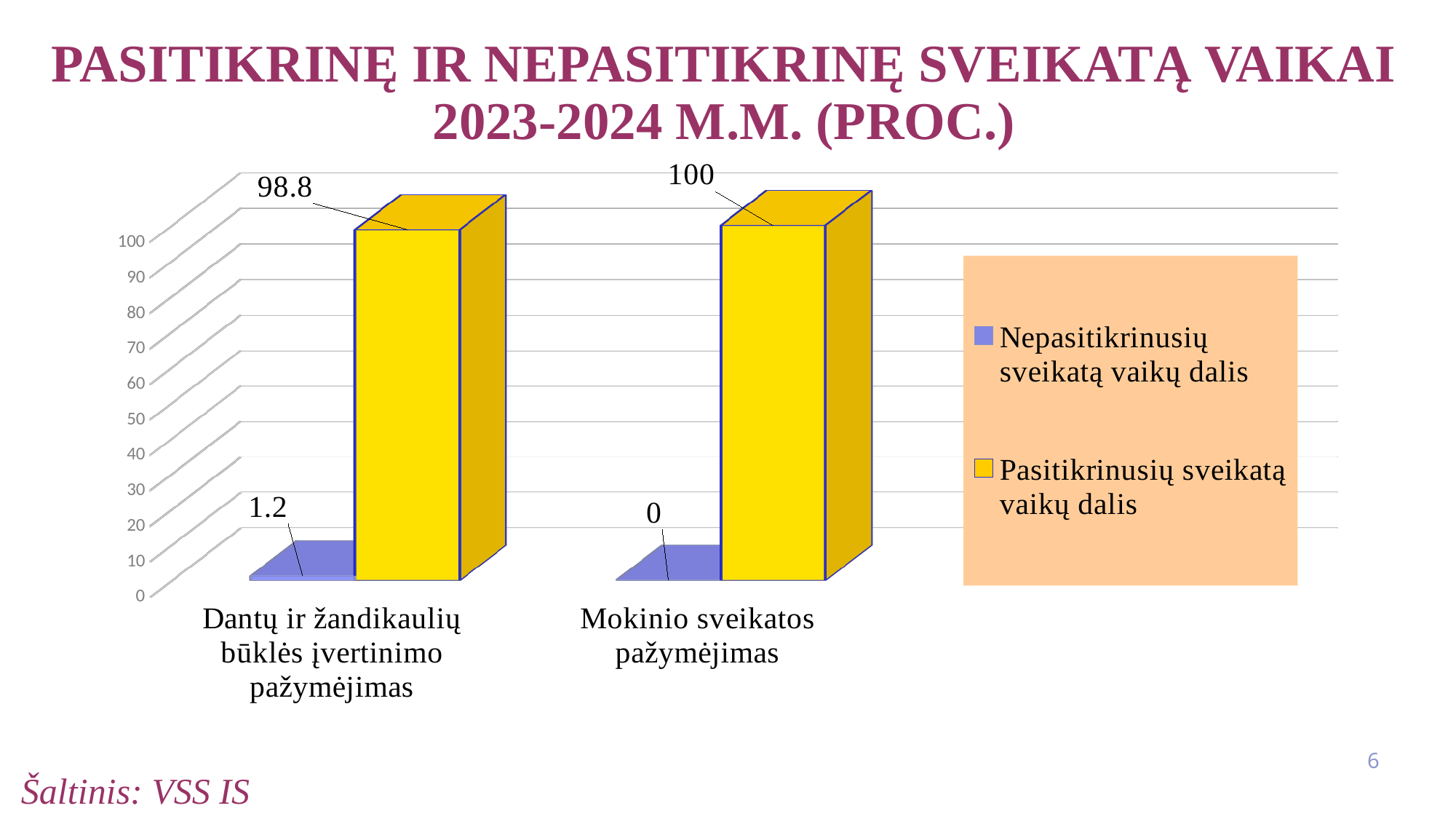
Which category has the higher value for 'Pasitikrinusių sveikatą vaikų dalis'? Mokinio sveikatos pažymėjimas What is the value of 'Pasitikrinusių sveikatą vaikų dalis' for 'Mokinio sveikatos pažymėjimas'? 100 What kind of chart is shown on the slide? Bar chart What colour represents 'Pasitikrinusių sveikatą vaikų dalis' in the chart? Yellow What is the value of 'Pasitikrinusių sveikatą vaikų dalis' for 'Dantų ir žandikaulių būklės įvertinimo pažymėjimas'? 98.8 What is the value of 'Nepasitikrinusių sveikatą vaikų dalis' for 'Dantų ir žandikaulių būklės įvertinimo pažymėjimas'? 1.2 How many series does the legend list? 2 For 'Dantų ir žandikaulių būklės įvertinimo pažymėjimas', which series has the larger value: 'Nepasitikrinusių sveikatą vaikų dalis' or 'Pasitikrinusių sveikatą vaikų dalis'? Pasitikrinusių sveikatą vaikų dalis What is the value of 'Nepasitikrinusių sveikatą vaikų dalis' for 'Mokinio sveikatos pažymėjimas'? 0 How many categories are shown on the x axis of the chart? 2 Which category has the lower value for 'Nepasitikrinusių sveikatą vaikų dalis'? Mokinio sveikatos pažymėjimas What is the difference between the 'Pasitikrinusių sveikatą vaikų dalis' values for 'Mokinio sveikatos pažymėjimas' and 'Dantų ir žandikaulių būklės įvertinimo pažymėjimas'? 1.2